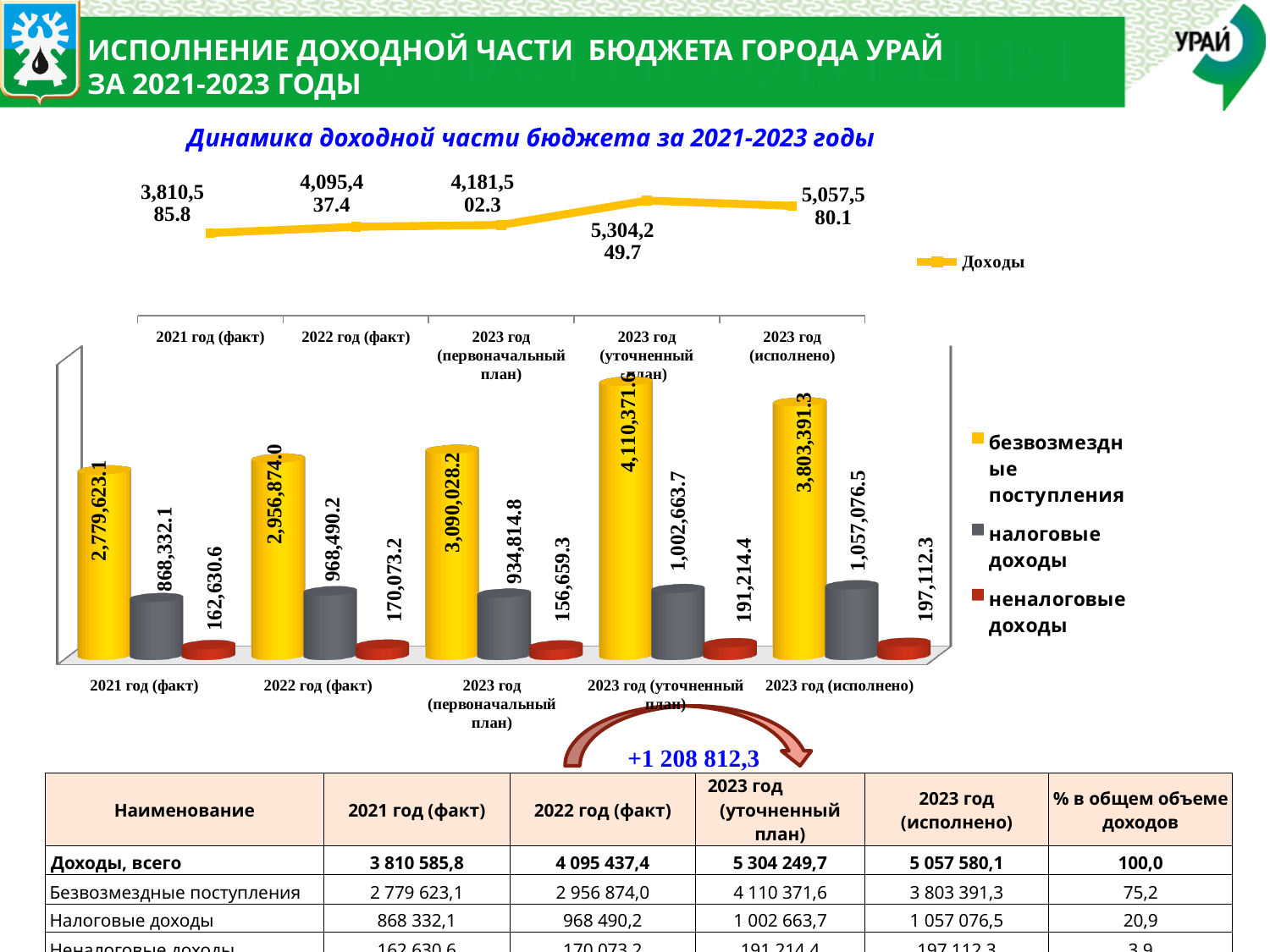
In the lower bar chart, which is larger: безвозмездные поступления for 2022 год (факт) or for 2023 год (первоначальный план)? 2023 год (первоначальный план) In the upper line chart, what is the value for 2021 год (факт)? 3,810,585.8 In the lower bar chart, what is the value of неналоговые доходы for 2022 год (факт)? 170,073.2 In the lower bar chart, what is the value of налоговые доходы for 2023 год (исполнено)? 1,057,076.5 In the lower bar chart, what is the difference between налоговые доходы for 2023 год (исполнено) and 2021 год (факт)? 188,744.4 In the upper line chart, which category has the highest value? 2023 год (уточненный план) What type of chart is the lower chart showing безвозмездные поступления, налоговые доходы and неналоговые доходы? bar chart In the lower bar chart, which category has the lowest value for неналоговые доходы? 2023 год (первоначальный план) What type of chart is the upper chart titled 'Динамика доходной части бюджета за 2021-2023 годы'? line chart In the lower bar chart, what is the value of безвозмездные поступления for 2023 год (исполнено)? 3,803,391.3 In the upper line chart, how many data points are plotted? 5 How many series does the legend of the lower bar chart list? 3